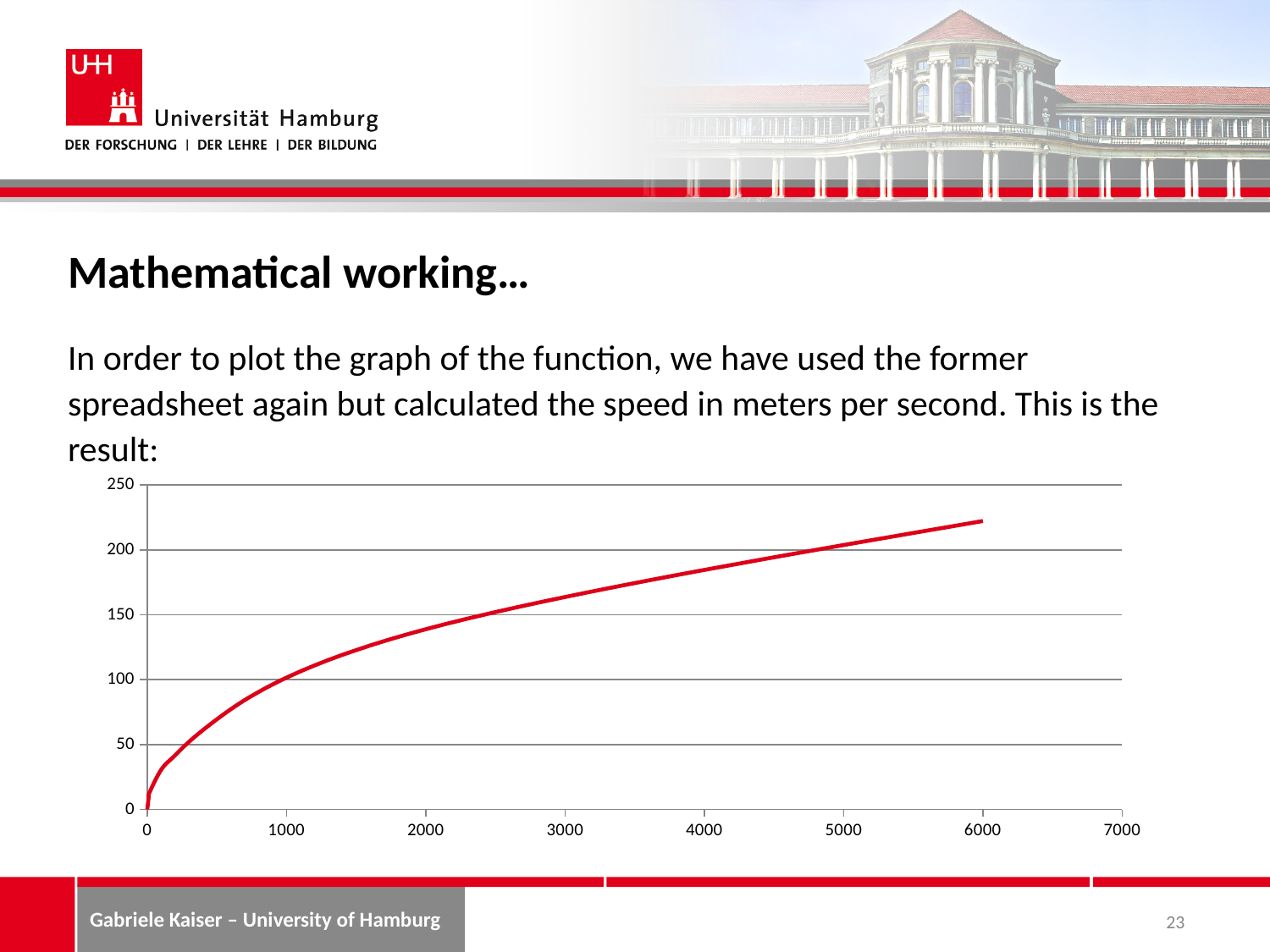
How many lines are plotted on the chart? 1 Is the value of the curve at x = 4000 greater or less than 200? less Is the value of the curve at x = 6000 greater or less than 200? greater Do the values on the chart rise or fall as the x axis increases from 0 to 6000? rise Is the value of the curve at x = 2000 greater or less than 100? greater What is the highest tick value shown on the vertical axis of the chart? 250 What kind of chart is shown on the slide? line chart What is the highest tick value shown on the horizontal axis of the chart? 7000